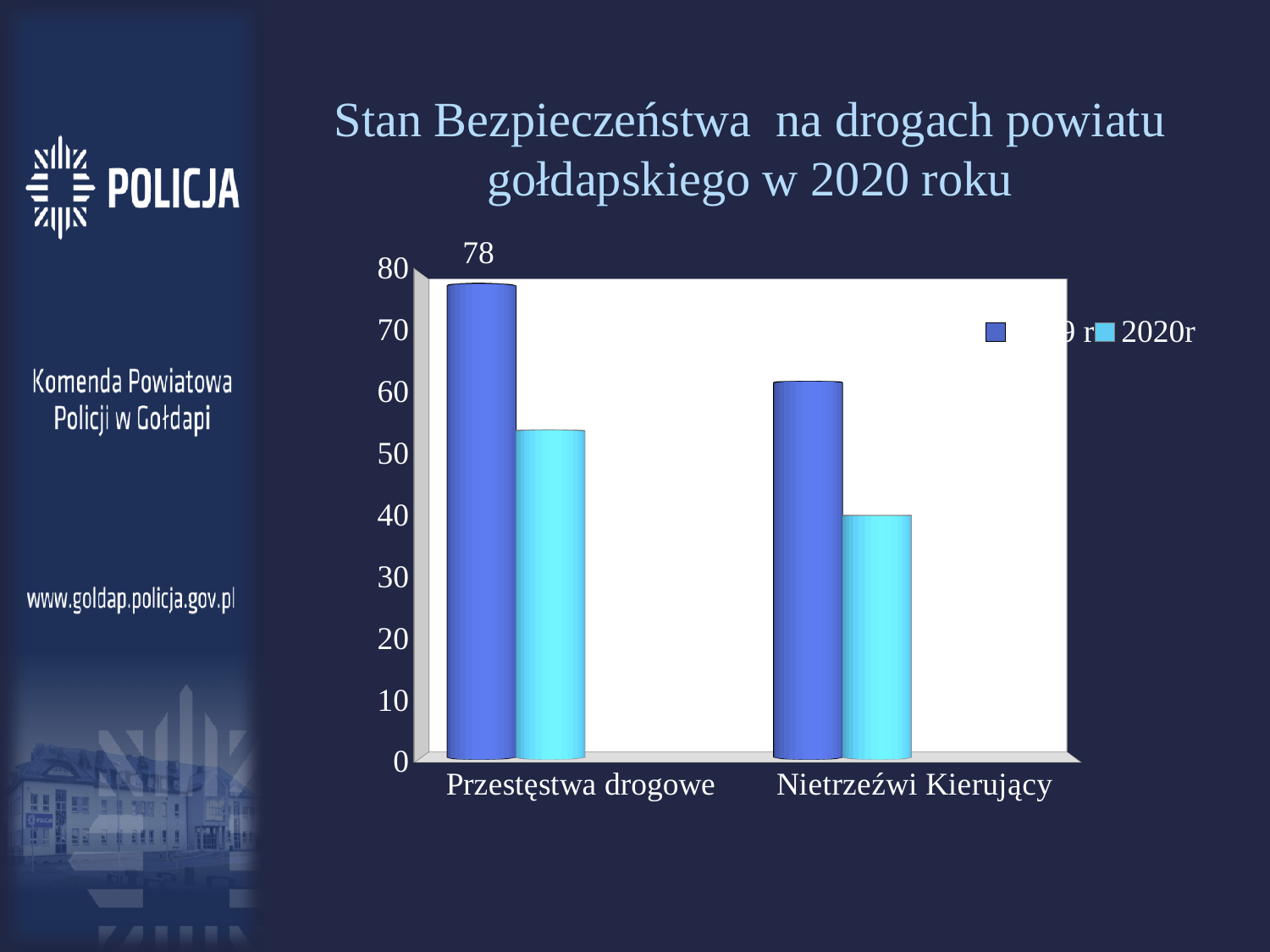
Is the darker blue bar for Nietrzeźwi Kierujący greater or less than 50? greater In the 2020r series, which category has the higher value: Przestęstwa drogowe or Nietrzeźwi Kierujący? Przestęstwa drogowe For Nietrzeźwi Kierujący, which bar is taller: the darker blue bar or the 2020r bar? the darker blue bar What value is printed as a data label above the tallest bar in the chart? 78 Which category has the lowest 2020r bar? Nietrzeźwi Kierujący Which category has the highest 2020r bar? Przestęstwa drogowe How many categories are shown on the x axis of the chart? 2 What is the title of the slide containing the chart? Stan Bezpieczeństwa na drogach powiatu gołdapskiego w 2020 roku Is the 2020r value for Przestęstwa drogowe greater or less than 50? greater What kind of chart is shown on the slide? bar chart Is the 2020r value for Nietrzeźwi Kierujący greater or less than 50? less How many series does the chart's legend list? 2